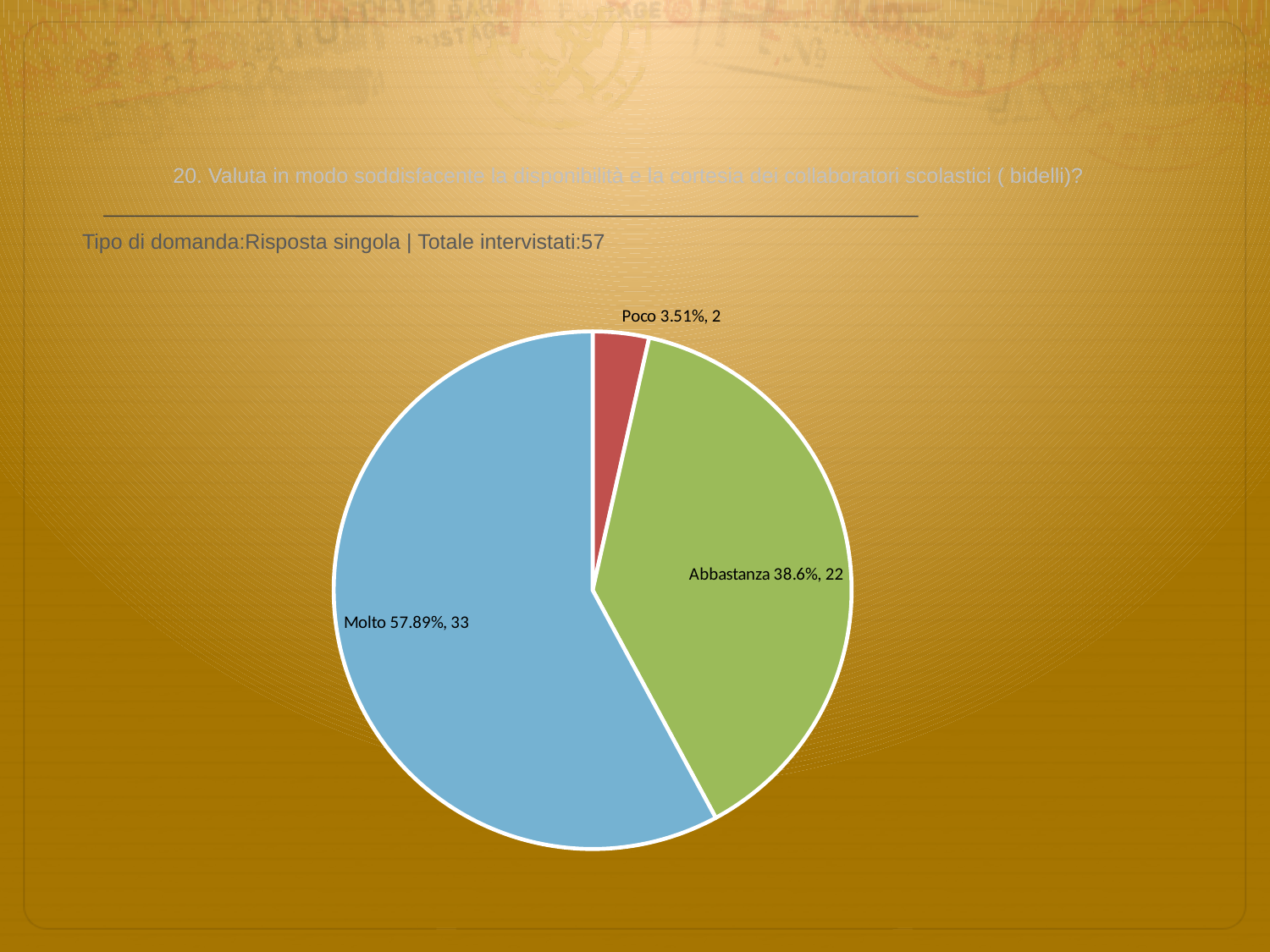
What kind of chart is shown on the slide? Pie chart How many respondents chose Poco? 2 What percentage share does the Abbastanza slice have? 38.6% Which category has the largest slice? Molto How many respondents chose Molto? 33 Which category has the smallest slice? Poco How many slices does the pie chart have? 3 Which slice is larger, Abbastanza or Poco? Abbastanza What is the difference in respondent count between Molto and Abbastanza? 11 What percentage share does the Molto slice have? 57.89% What percentage share does the Poco slice have? 3.51% How many respondents chose Abbastanza? 22